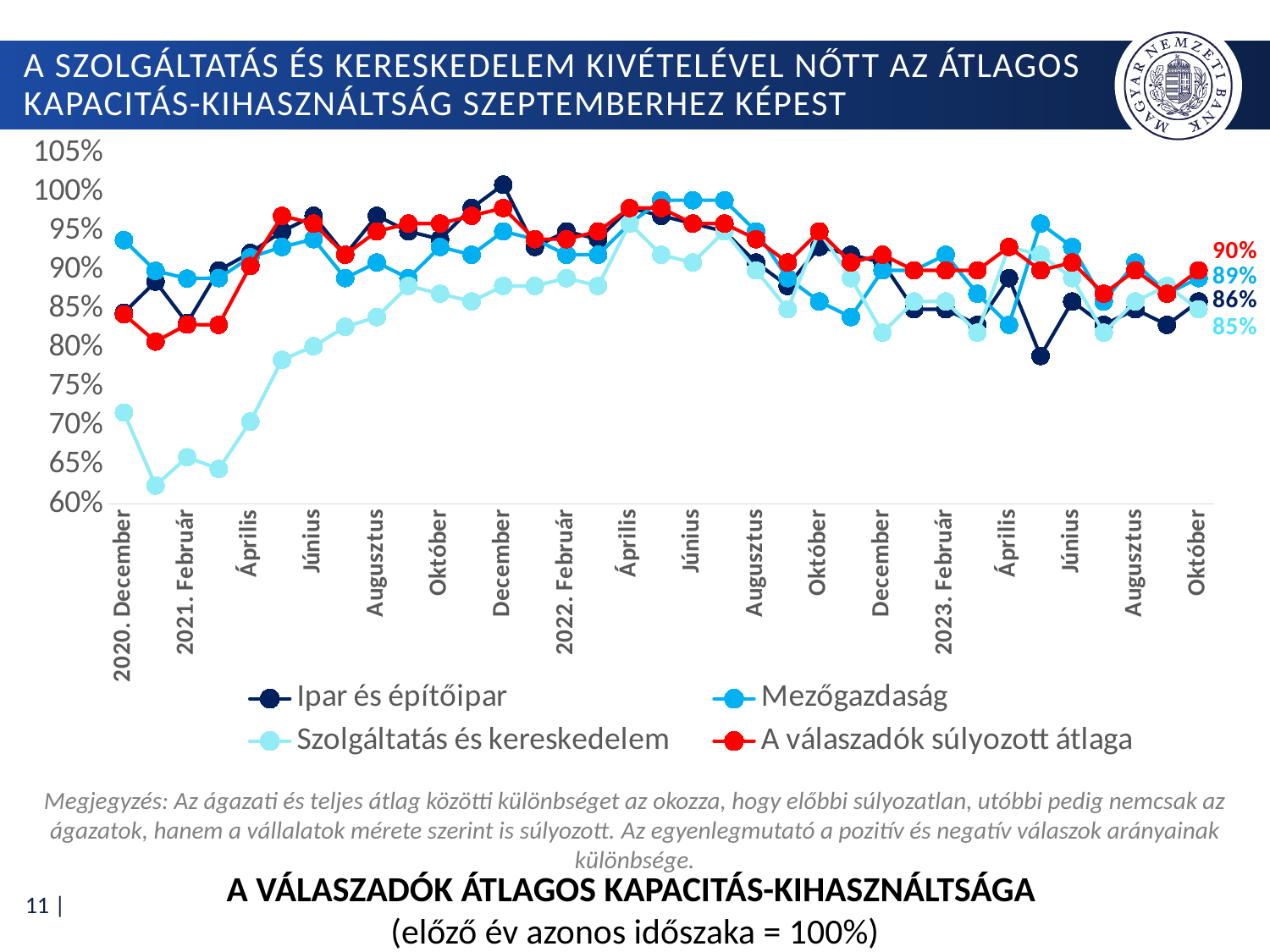
What is the value of 'Ipar és építőipar' at the last point (2023 Október)? 86% What is the value of 'Szolgáltatás és kereskedelem' at the last point (2023 Október)? 85% What is the difference between the final values of 'A válaszadók súlyozott átlaga' and 'Szolgáltatás és kereskedelem'? 5 percentage points How many series does the legend list? 4 What kind of chart is shown on the slide? Line chart What is the value of 'Mezőgazdaság' at the last point (2023 Október)? 89% What is the value of 'A válaszadók súlyozott átlaga' at the last point (2023 Október)? 90% At the last point, which is larger: 'Mezőgazdaság' or 'Ipar és építőipar'? Mezőgazdaság Which series has the highest value at the last point (2023 Október)? A válaszadók súlyozott átlaga Does the 'Szolgáltatás és kereskedelem' series rise or fall between 2021 Február and 2022 Április? Rise Which series has the lowest value at the last point (2023 Október)? Szolgáltatás és kereskedelem